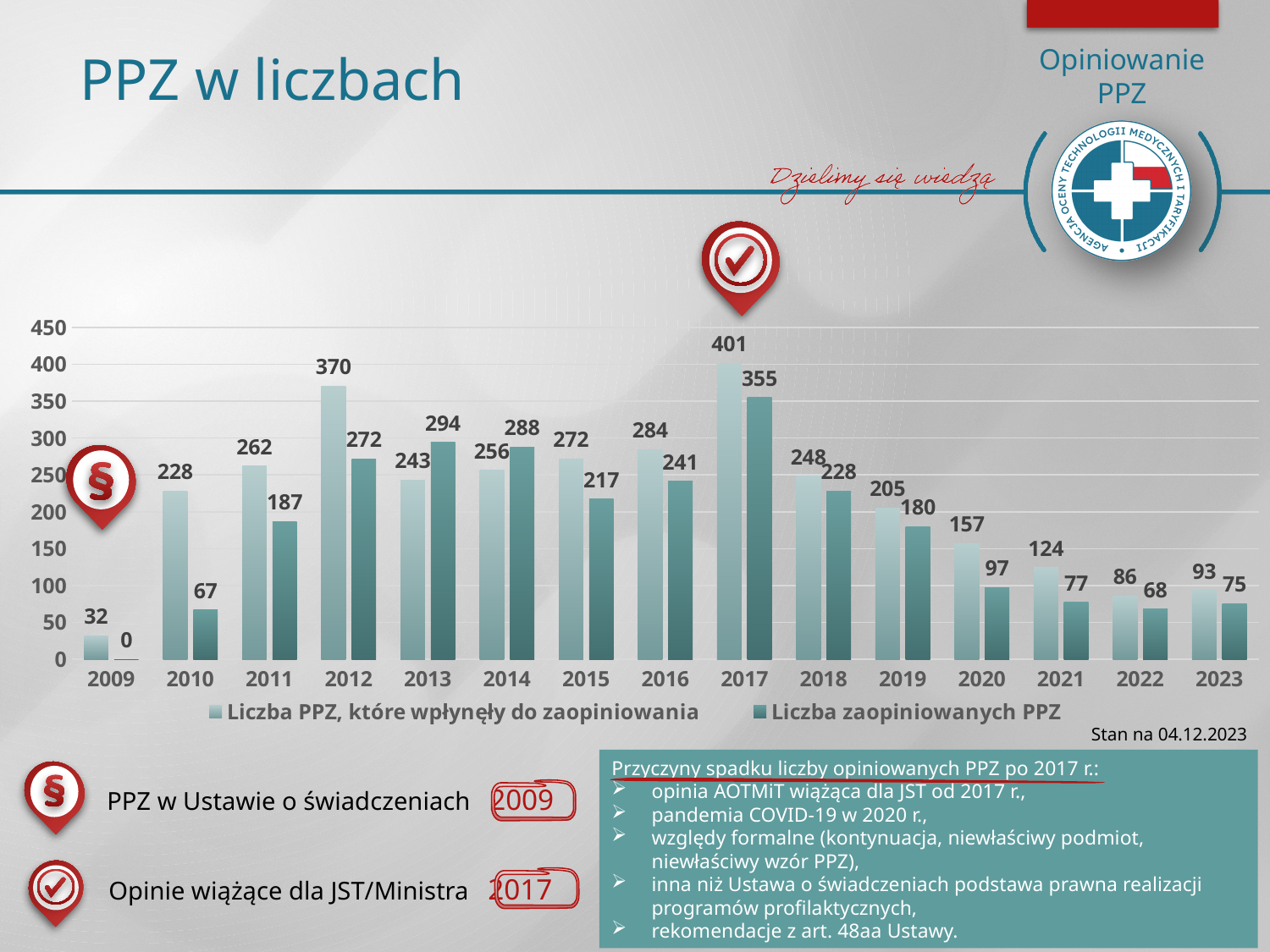
Is the value of 'Liczba zaopiniowanych PPZ' for 2020 greater or less than 100? less How many series does the legend list? 2 What type of chart is shown on the slide? bar chart What is the value of 'Liczba zaopiniowanych PPZ' for 2009? 0 Which is larger in 2014: 'Liczba PPZ, które wpłynęły do zaopiniowania' or 'Liczba zaopiniowanych PPZ'? Liczba zaopiniowanych PPZ What is the value of 'Liczba PPZ, które wpłynęły do zaopiniowania' for 2017? 401 In which year is 'Liczba zaopiniowanych PPZ' the highest? 2017 Do the values of 'Liczba PPZ, które wpłynęły do zaopiniowania' rise or fall from 2017 to 2022? fall What is the value of 'Liczba zaopiniowanych PPZ' for 2013? 294 What is the difference between 'Liczba PPZ, które wpłynęły do zaopiniowania' and 'Liczba zaopiniowanych PPZ' in 2012? 98 How many years are shown on the x axis of the chart? 15 In which year is 'Liczba PPZ, które wpłynęły do zaopiniowania' the lowest? 2009